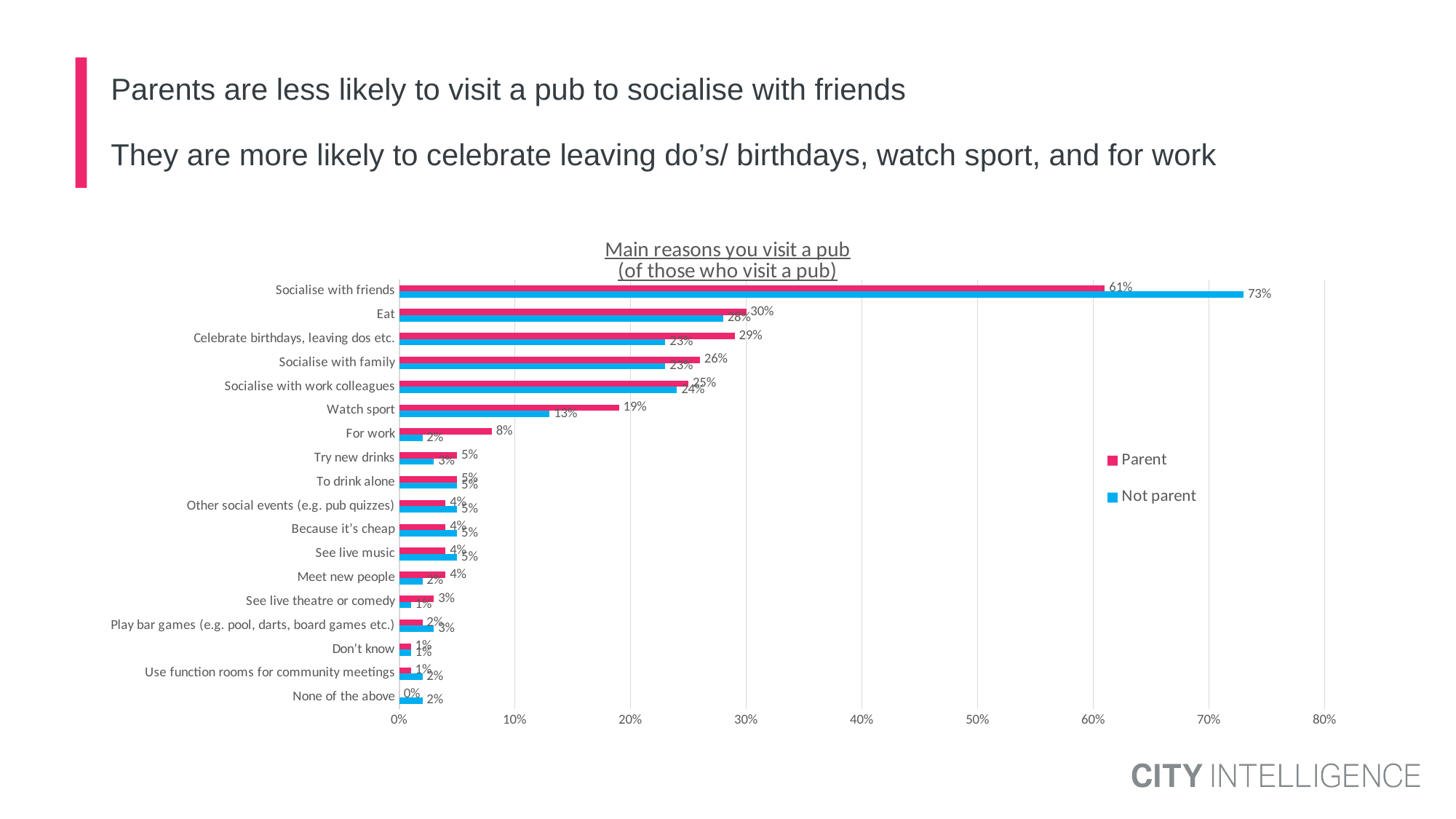
Is the Not parent value for 'Socialise with friends' greater or less than 70%? greater What is the difference between the Parent and Not parent values for 'Watch sport'? 6% What percentage of parents say they visit a pub to socialise with friends? 61% What type of chart is shown on the slide? Bar chart What is the Parent value for 'For work'? 8% What is the difference between the Not parent and Parent values for 'Socialise with friends'? 12% What is the Not parent value for 'Watch sport'? 13% How many reasons (categories) are listed on the chart? 18 For 'Celebrate birthdays, leaving dos etc.', which group has the larger value, Parent or Not parent? Parent How many series does the legend list? 2 Which reason has the highest Not parent value? Socialise with friends Which reason has the lowest Parent value? None of the above